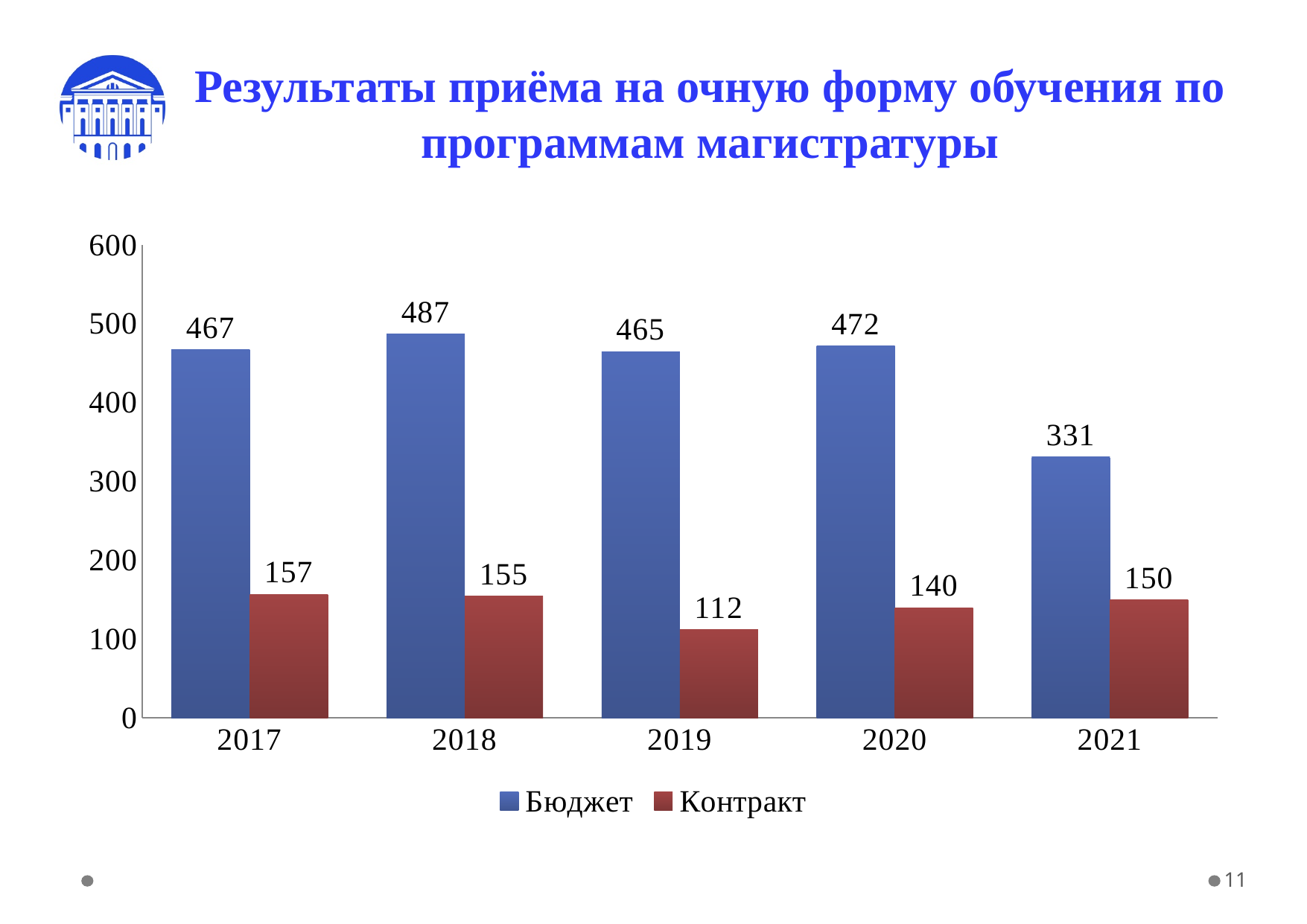
Which colour represents the Контракт series? red How many years are shown on the x axis? 5 What kind of chart is shown on the slide? bar chart What is the value for Контракт in 2019? 112 What is the value for Бюджет in 2018? 487 What is the value for Бюджет in 2021? 331 How many series does the legend list? 2 What is the difference between the Бюджет and Контракт values in 2020? 332 Which is larger: the Контракт value in 2017 or in 2021? 2017 Is the Бюджет value for 2021 greater or less than 400? less Which year has the lowest Контракт value? 2019 Which year has the highest Бюджет value? 2018